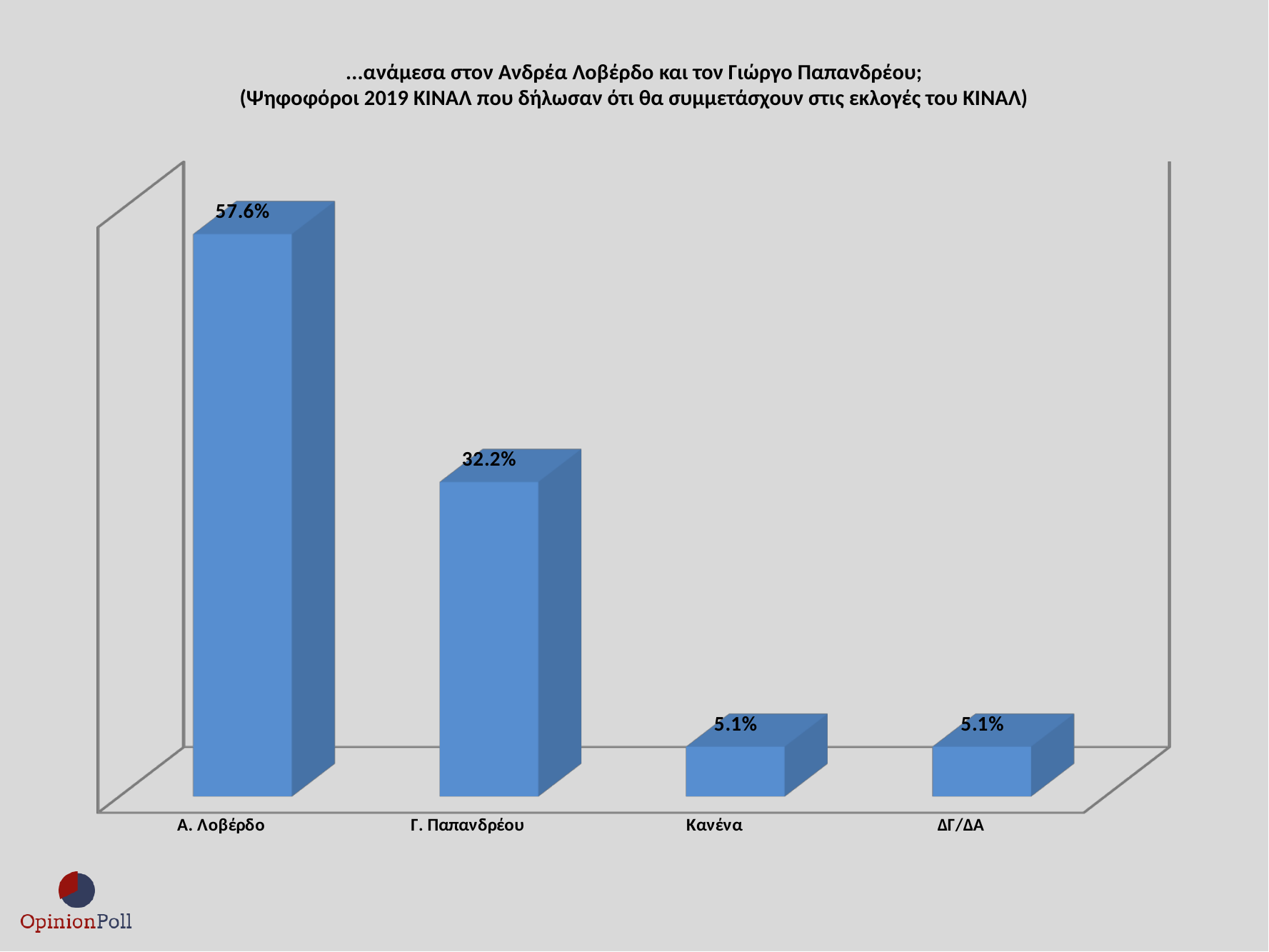
What is the value for Κανένα? 5.1% Which is larger, the value for Γ. Παπανδρέου or the value for ΔΓ/ΔΑ? Γ. Παπανδρέου What is the value for ΔΓ/ΔΑ? 5.1% What is the difference between the values for Α. Λοβέρδο and Γ. Παπανδρέου? 25.4% What colour are the bars in the chart? Blue Do the values rise or fall from left to right across the categories? Fall What kind of chart is shown on the slide? Bar chart Which category has the highest value? Α. Λοβέρδο How many categories are shown on the chart? 4 What is the value for Γ. Παπανδρέου? 32.2% What is the difference between the values for Γ. Παπανδρέου and Κανένα? 27.1% What is the value for Α. Λοβέρδο? 57.6%